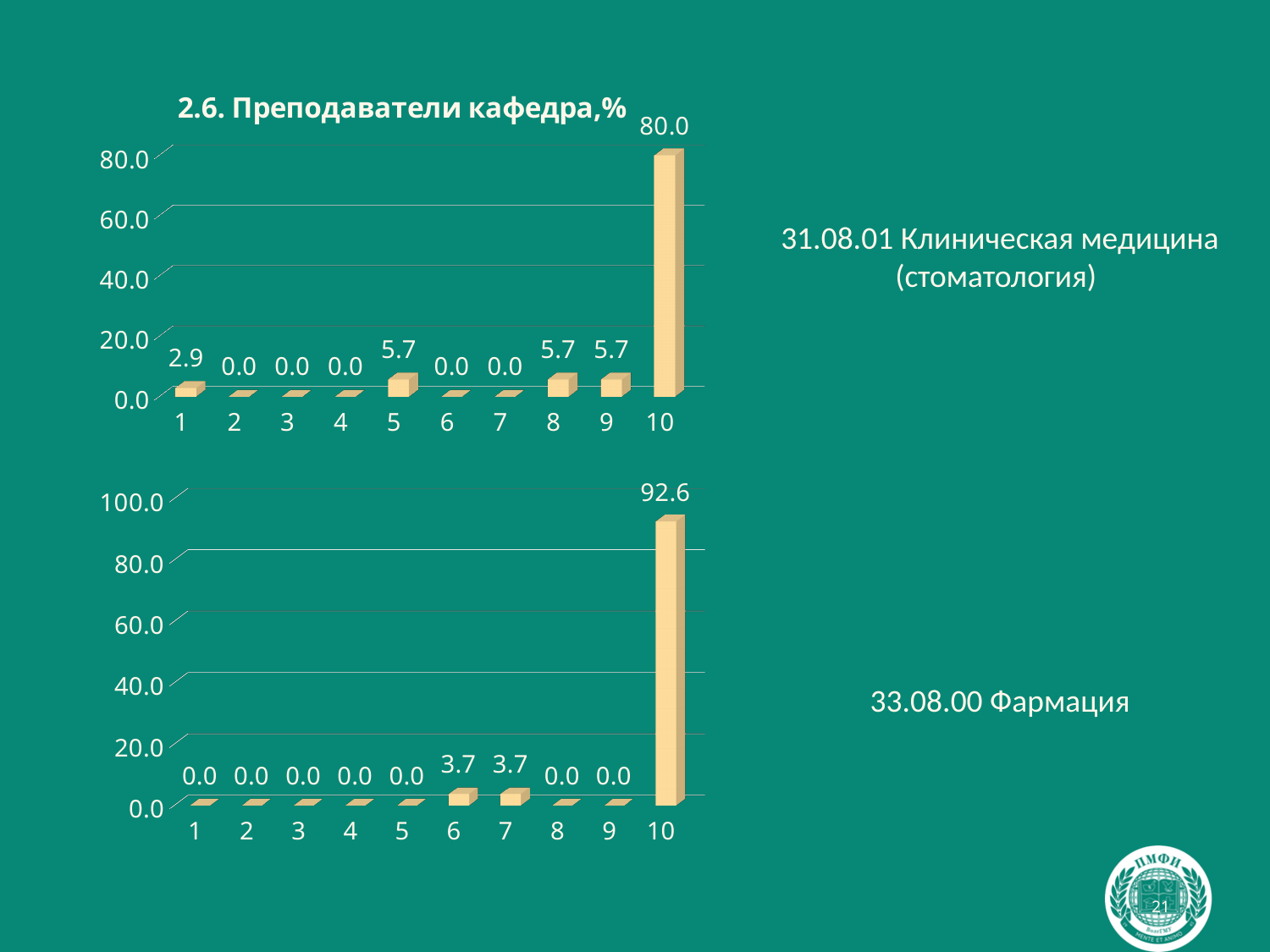
How many categories are shown on the x axis of the bottom chart? 10 In the top chart, what is the value for category 1? 2.9 In the top chart, what is the value for category 10? 80.0 In the top chart, what is the value for category 5? 5.7 In the top chart, what is the difference between the values for category 10 and category 1? 77.1 In the bottom chart, what is the value for category 6? 3.7 In the bottom chart, what is the difference between the values for category 10 and category 7? 88.9 In the top chart, which is larger, the value for category 5 or the value for category 1? category 5 What type of chart is the top chart? bar chart In the bottom chart, which category has the highest value? 10 In the top chart, which category has the highest value? 10 In the bottom chart, what is the value for category 10? 92.6